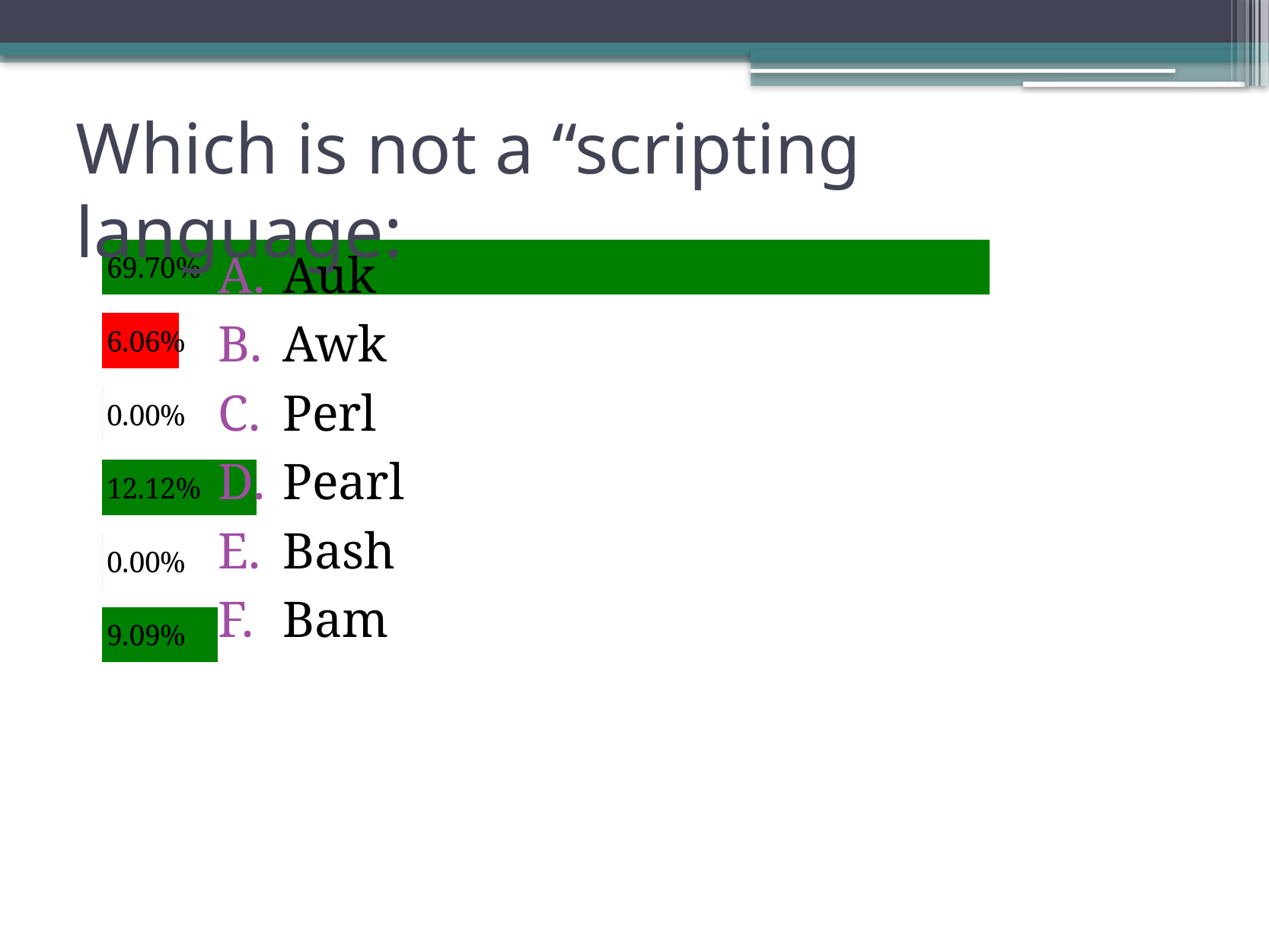
What percentage of responses did option A, Auk, receive? 69.70% What percentage of responses did option D, Pearl, receive? 12.12% Which options received 0.00% of responses? Perl and Bash Which received a larger share of responses, Awk or Bam? Bam What is the difference in percentage between Pearl and Bam? 3.03% Which option's bar is coloured red? Awk What percentage of responses did option F, Bam, receive? 9.09% Which option received the highest percentage of responses? Auk What is the difference in percentage between Auk and Pearl? 57.58% How many answer options are shown in the chart? 6 What kind of chart is shown on the slide? Bar chart What percentage of responses did option B, Awk, receive? 6.06%